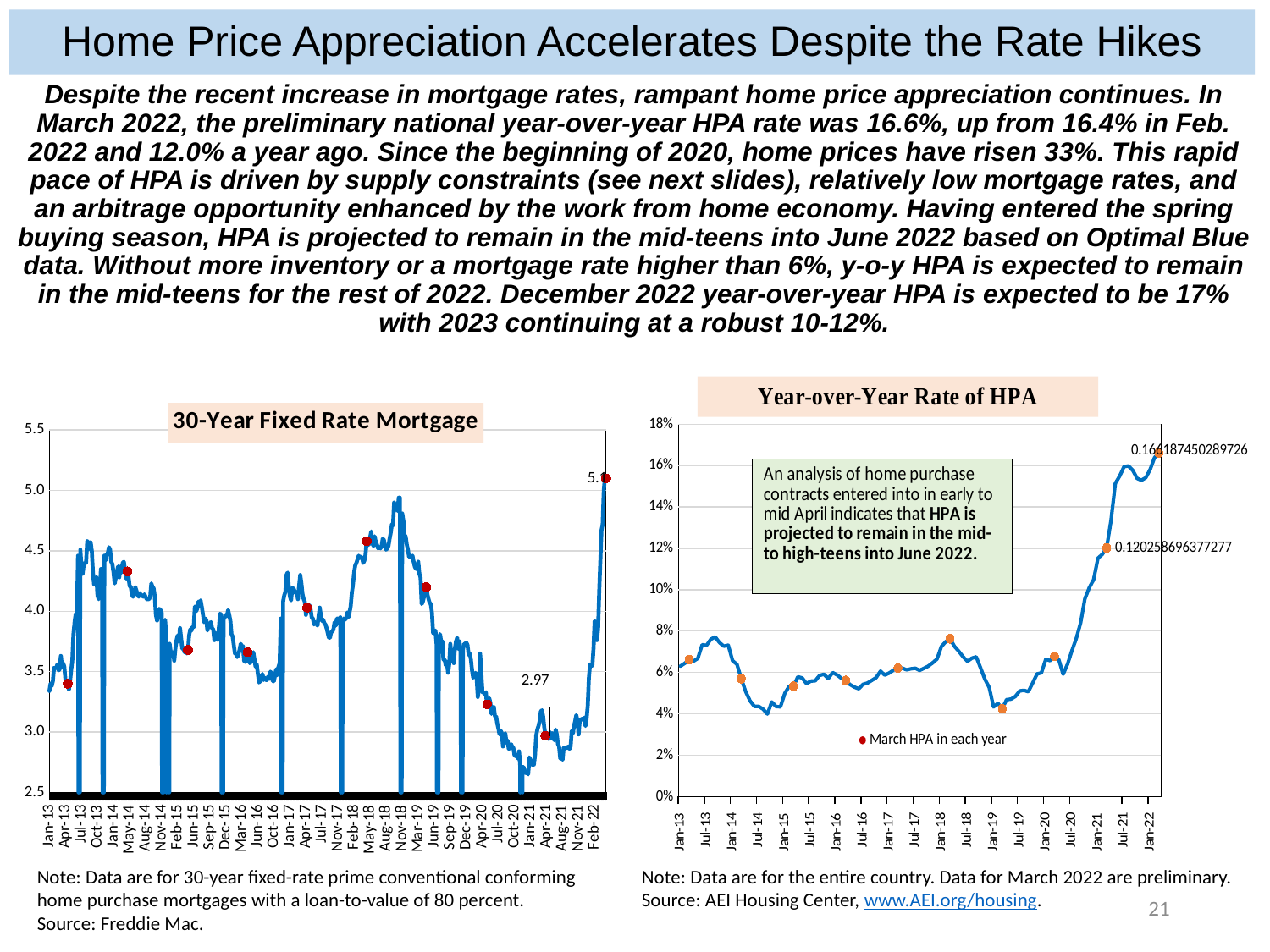
What is the title of the chart on the left side of the slide? 30-Year Fixed Rate Mortgage On the 'Year-over-Year Rate of HPA' chart, what value is printed as the data label at the point near Jan-21? 0.120258696377277 On the '30-Year Fixed Rate Mortgage' chart, is the value around Nov-18 greater or less than 4.5? greater On the 'Year-over-Year Rate of HPA' chart, do values rise or fall between Jan-21 and Jan-22? rise What kind of chart is the '30-Year Fixed Rate Mortgage' chart on the left? line chart On the '30-Year Fixed Rate Mortgage' chart, what value is printed as a data label near Apr-21? 2.97 On the 'Year-over-Year Rate of HPA' chart, what value is printed as the data label at the last point (early 2022)? 0.166187450289726 On the '30-Year Fixed Rate Mortgage' chart, is the value around Jan-21 greater or less than 3.0? less On the 'Year-over-Year Rate of HPA' chart, which is larger: the value at Jan-13 or the value at Jan-22? Jan-22 What kind of chart is the 'Year-over-Year Rate of HPA' chart on the right? line chart What legend entry is shown on the 'Year-over-Year Rate of HPA' chart? March HPA in each year On the 'Year-over-Year Rate of HPA' chart, is the value around Jan-19 greater or less than 6%? less